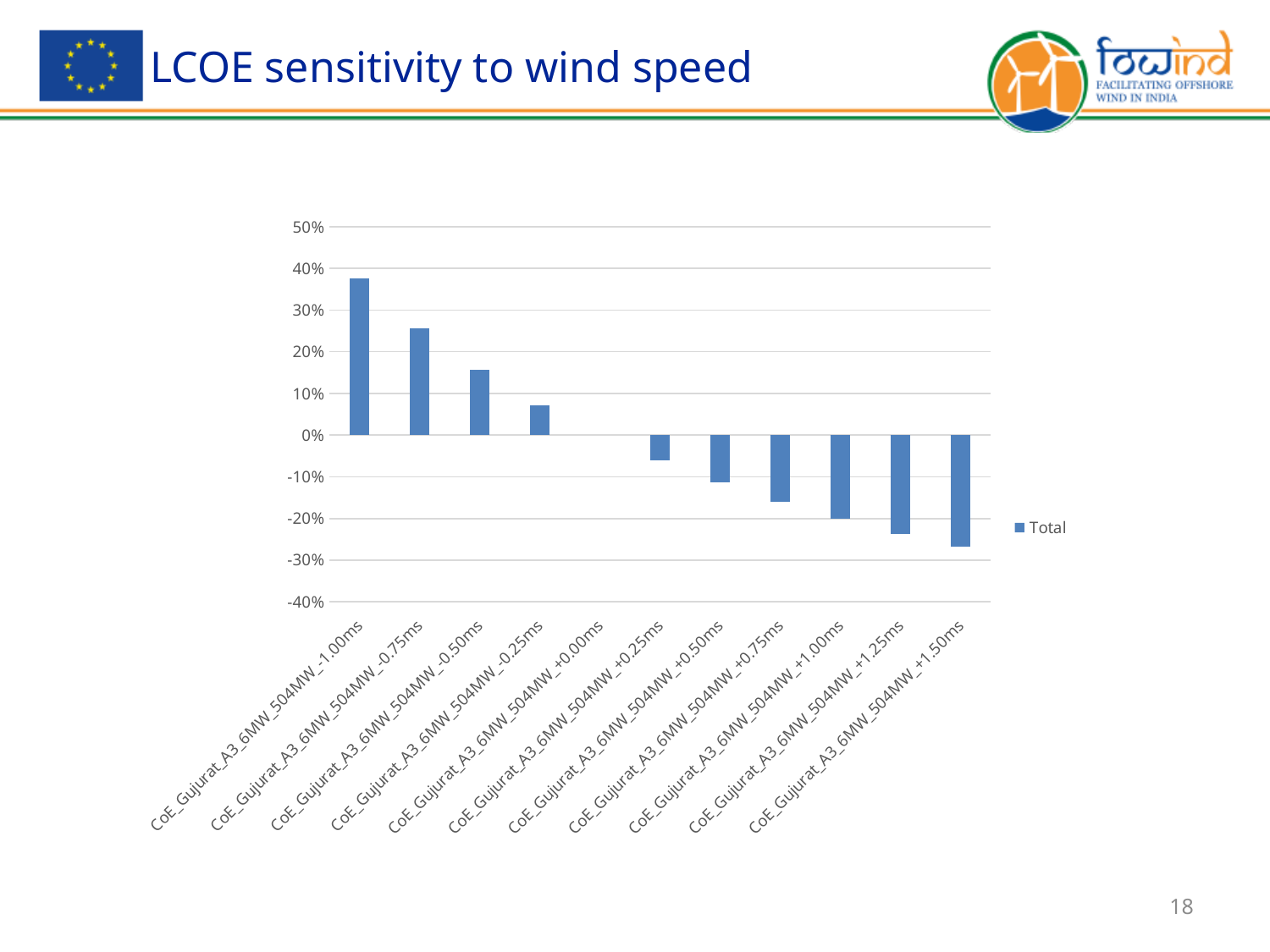
Is the value for CoE_Gujurat_A3_6MW_504MW_+1.50ms greater or less than -20%? less Which category has the highest value? CoE_Gujurat_A3_6MW_504MW_-1.00ms Which category has the lowest value? CoE_Gujurat_A3_6MW_504MW_+1.50ms How many categories are plotted on the x axis? 11 What is the name of the series shown in the legend? Total How many series does the legend list? 1 Do the values rise or fall moving left to right along the x axis? fall Is the value for CoE_Gujurat_A3_6MW_504MW_+0.75ms greater or less than -10%? less Is the value for CoE_Gujurat_A3_6MW_504MW_-0.75ms greater or less than 20%? greater What kind of chart is shown on the slide? bar chart Which is larger, the value for CoE_Gujurat_A3_6MW_504MW_-0.50ms or for CoE_Gujurat_A3_6MW_504MW_-0.25ms? CoE_Gujurat_A3_6MW_504MW_-0.50ms